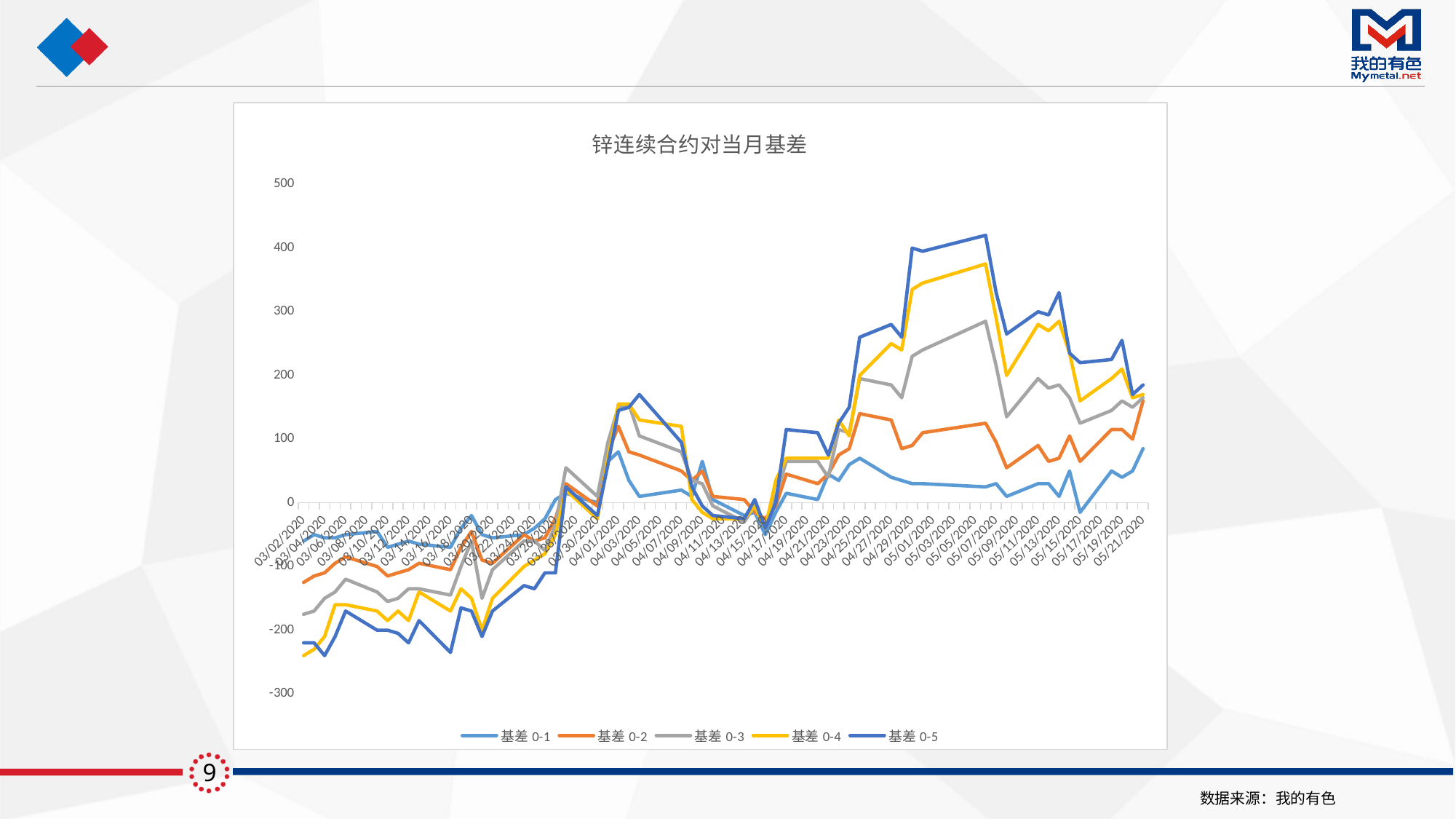
What is the title of the chart? 锌连续合约对当月基差 How many series does the legend list? 5 Is the value for 基差 0-5 on 05/05/2020 greater or less than 400? greater Which series reaches the highest value on the chart? 基差 0-5 Is the value for 基差 0-1 on 05/05/2020 greater or less than 100? less On 03/02/2020, which is larger: 基差 0-2 or 基差 0-4? 基差 0-2 What kind of chart is shown on the slide? line chart Is the value for 基差 0-4 on 05/05/2020 greater or less than 300? greater On 05/05/2020, which is larger: 基差 0-5 or 基差 0-1? 基差 0-5 Does 基差 0-5 generally rise or fall from 03/02/2020 to 05/05/2020? rise Which series is drawn in yellow according to the legend? 基差 0-4